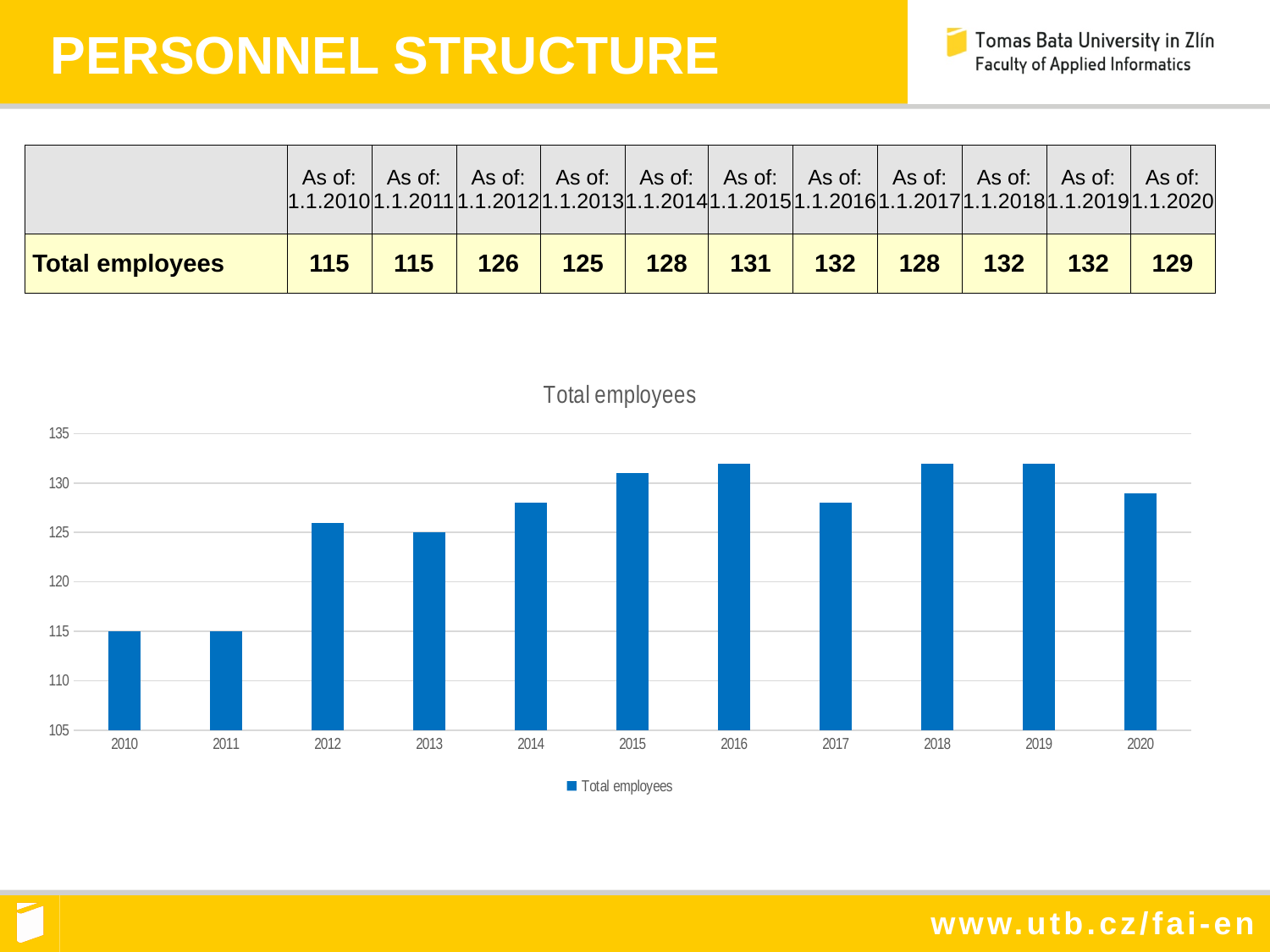
What is the highest value of total employees shown in the chart? 132 Which year has more total employees, 2014 or 2013? 2014 What is the total number of employees for 2015? 131 How many series does the chart legend list? 1 What is the lowest value of total employees shown in the chart? 115 Is the value for 2017 greater or less than 130? less What type of chart is shown on the slide? bar chart What is the title of the chart? Total employees How many years are plotted on the x axis of the chart? 11 What is the total number of employees for 2012? 126 What is the difference in total employees between 2016 and 2010? 17 What is the total number of employees for 2020? 129